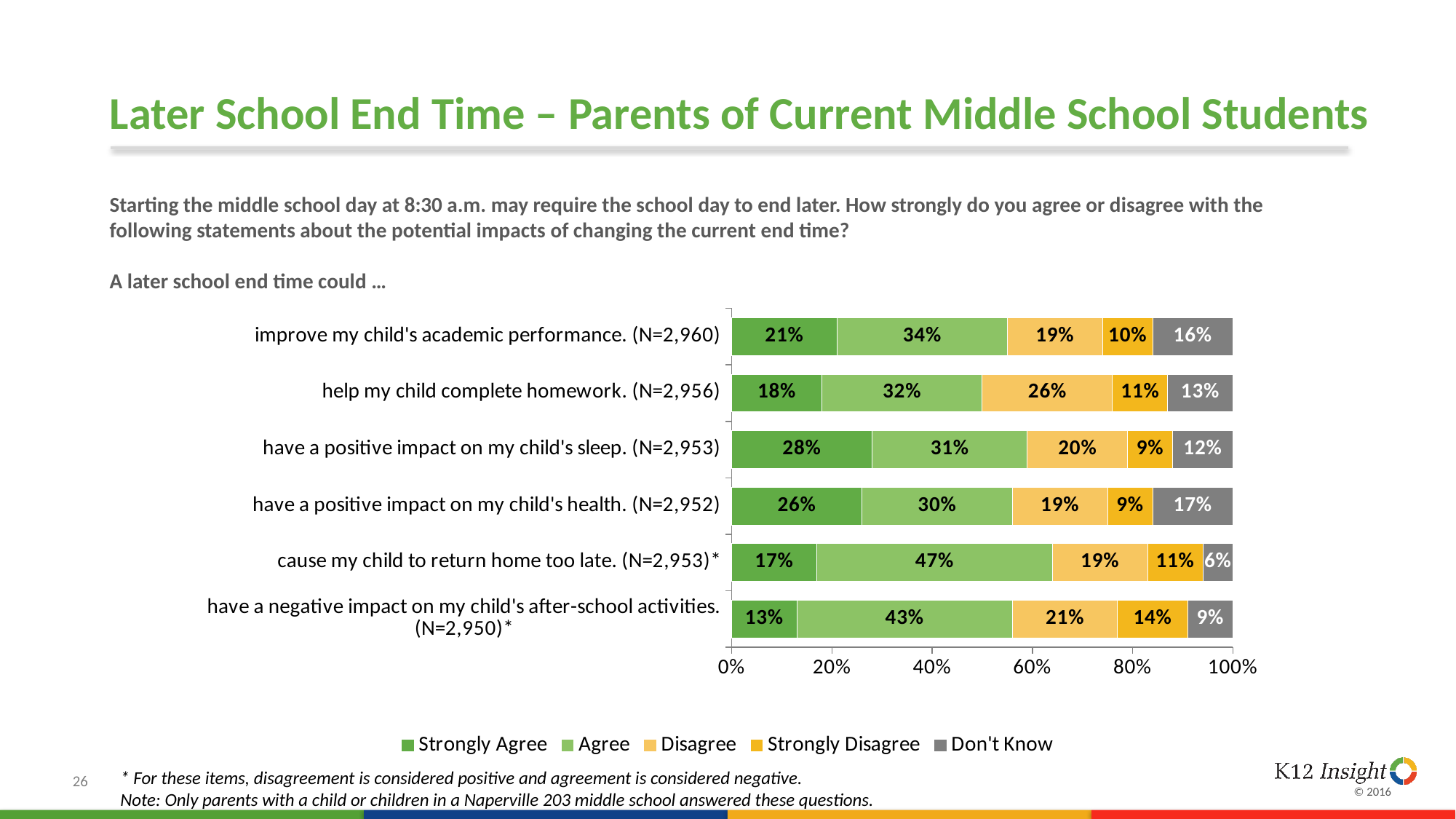
What type of chart is shown on the slide? Stacked bar chart How many percentage points higher is the Agree value for 'cause my child to return home too late' than for 'improve my child's academic performance'? 13 percentage points Which statement has the highest Strongly Agree percentage? have a positive impact on my child's sleep What is the combined Strongly Agree and Agree percentage for 'improve my child's academic performance'? 55% What is the Don't Know percentage for the statement about a positive impact on my child's health? 17% What percentage of parents agree that a later school end time could cause their child to return home too late? 47% How many response categories does the legend list? 5 Which statement has the highest Strongly Disagree percentage? have a negative impact on my child's after-school activities What percentage of parents strongly agree that a later school end time could have a positive impact on their child's sleep? 28% Which has a larger Disagree percentage: 'help my child complete homework' or 'have a positive impact on my child's sleep'? help my child complete homework Which statement has the lowest Don't Know percentage? cause my child to return home too late How many statements are shown in the chart? 6